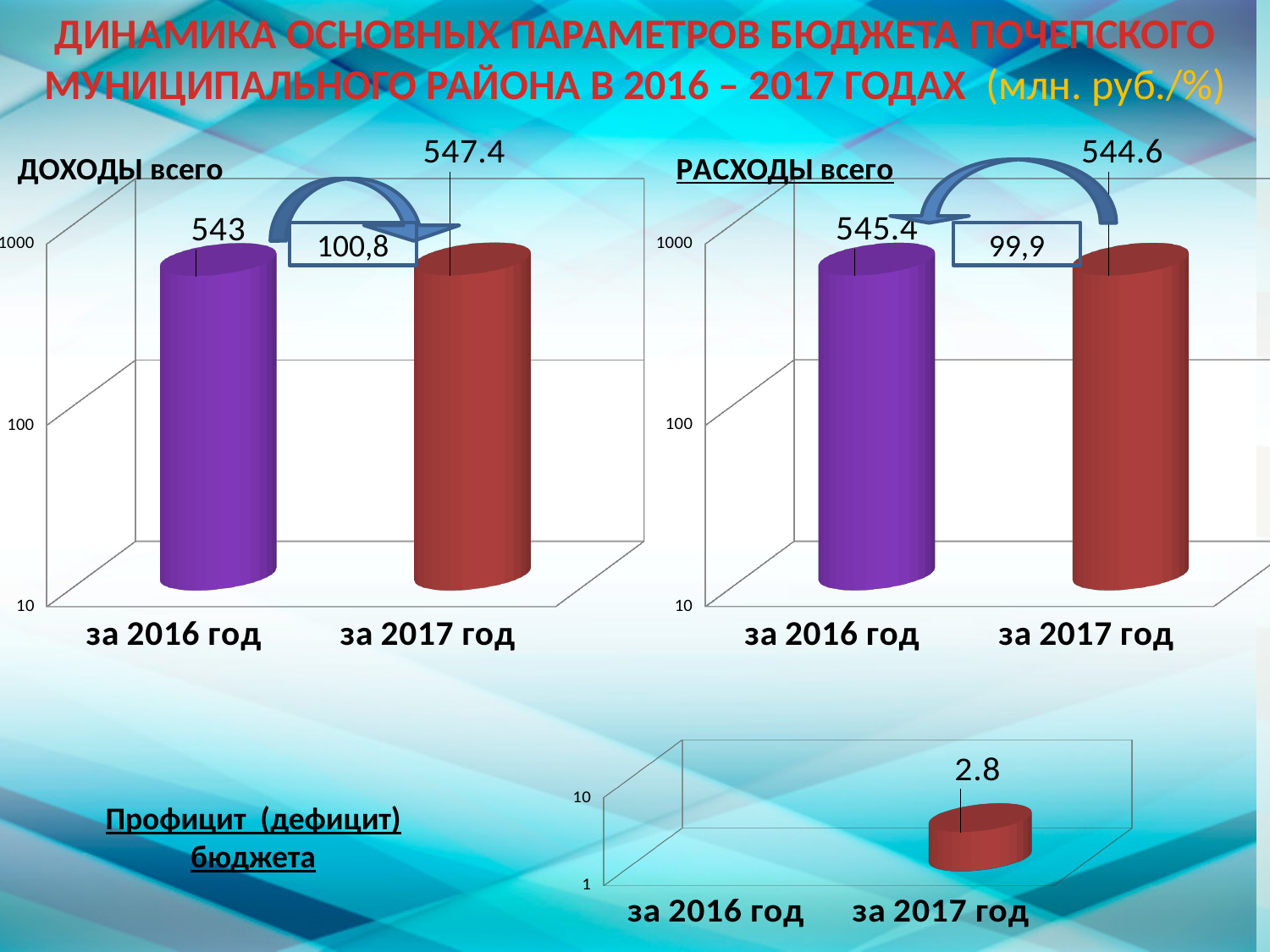
In the 'РАСХОДЫ всего' chart, what is the difference between the values for 'за 2016 год' and 'за 2017 год'? 0.8 In the 'ДОХОДЫ всего' chart, what is the difference between the values for 'за 2017 год' and 'за 2016 год'? 4.4 In the 'Профицит (дефицит) бюджета' chart, what is the value for 'за 2017 год'? 2.8 What percentage is shown in the box between the bars of the 'РАСХОДЫ всего' chart? 99,9 In the 'ДОХОДЫ всего' chart, what is the value for 'за 2017 год'? 547.4 In the 'ДОХОДЫ всего' chart, what is the value for 'за 2016 год'? 543 What kind of chart is the 'ДОХОДЫ всего' chart? bar chart In the 'РАСХОДЫ всего' chart, what is the value for 'за 2016 год'? 545.4 In the 'РАСХОДЫ всего' chart, which year has the higher value, 'за 2016 год' or 'за 2017 год'? за 2016 год In the 'ДОХОДЫ всего' chart, is the value for 'за 2016 год' greater or less than 100? greater In the 'ДОХОДЫ всего' chart, which year has the higher value, 'за 2016 год' or 'за 2017 год'? за 2017 год In the 'РАСХОДЫ всего' chart, what is the value for 'за 2017 год'? 544.6